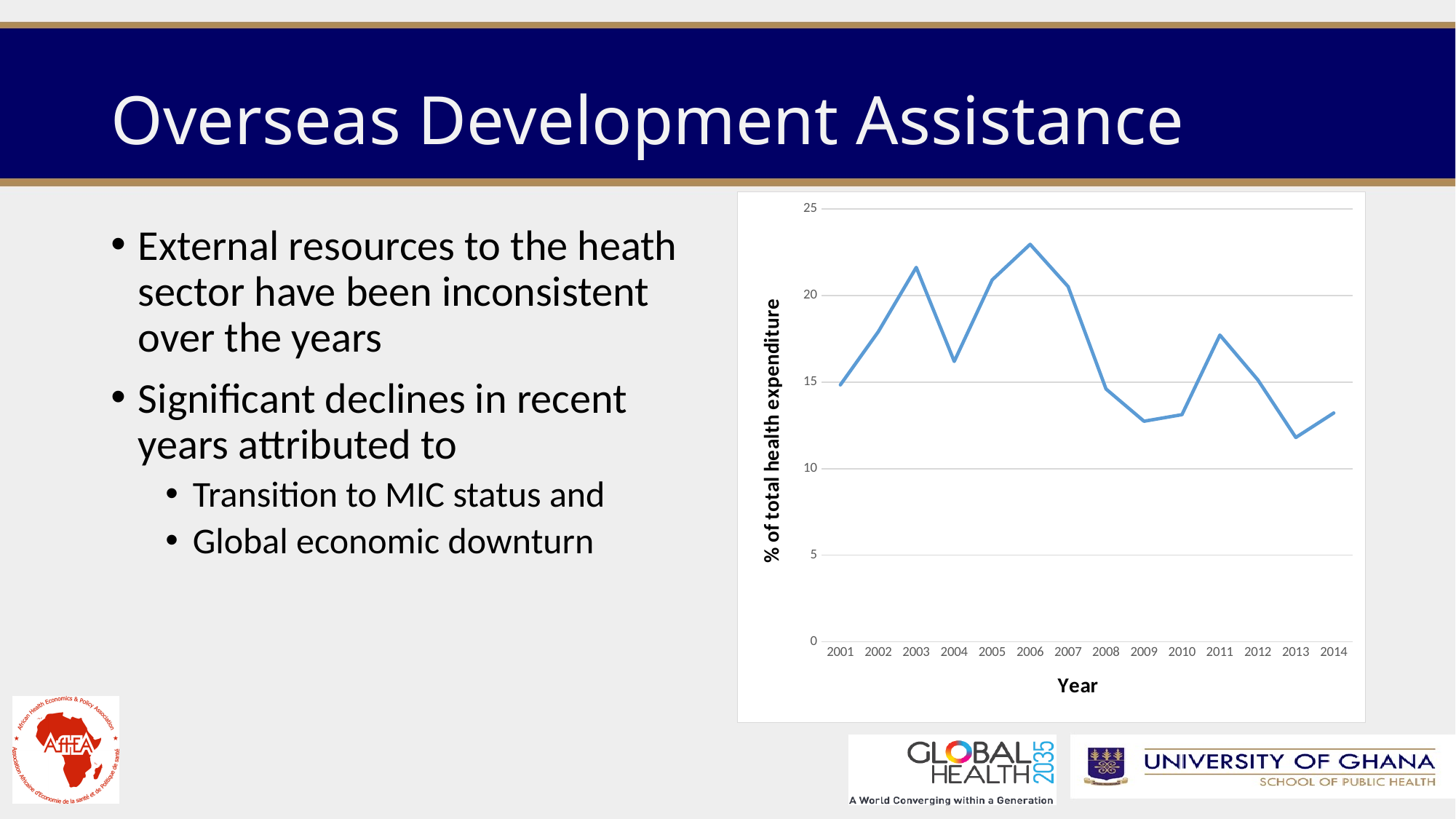
Does the line rise or fall between 2006 and 2009? fall In which year does the line reach its highest value? 2006 What is the label on the horizontal axis of the chart? Year What kind of chart is shown on the slide? line chart Which year has the larger value, 2003 or 2004? 2003 Is the value for 2009 greater or less than 15? less Is the value for 2006 greater or less than 20? greater Is the value for 2013 greater or less than 15? less How many years are plotted along the x axis of the chart? 14 In which year does the line reach its lowest value? 2013 What is the label on the vertical axis of the chart? % of total health expenditure